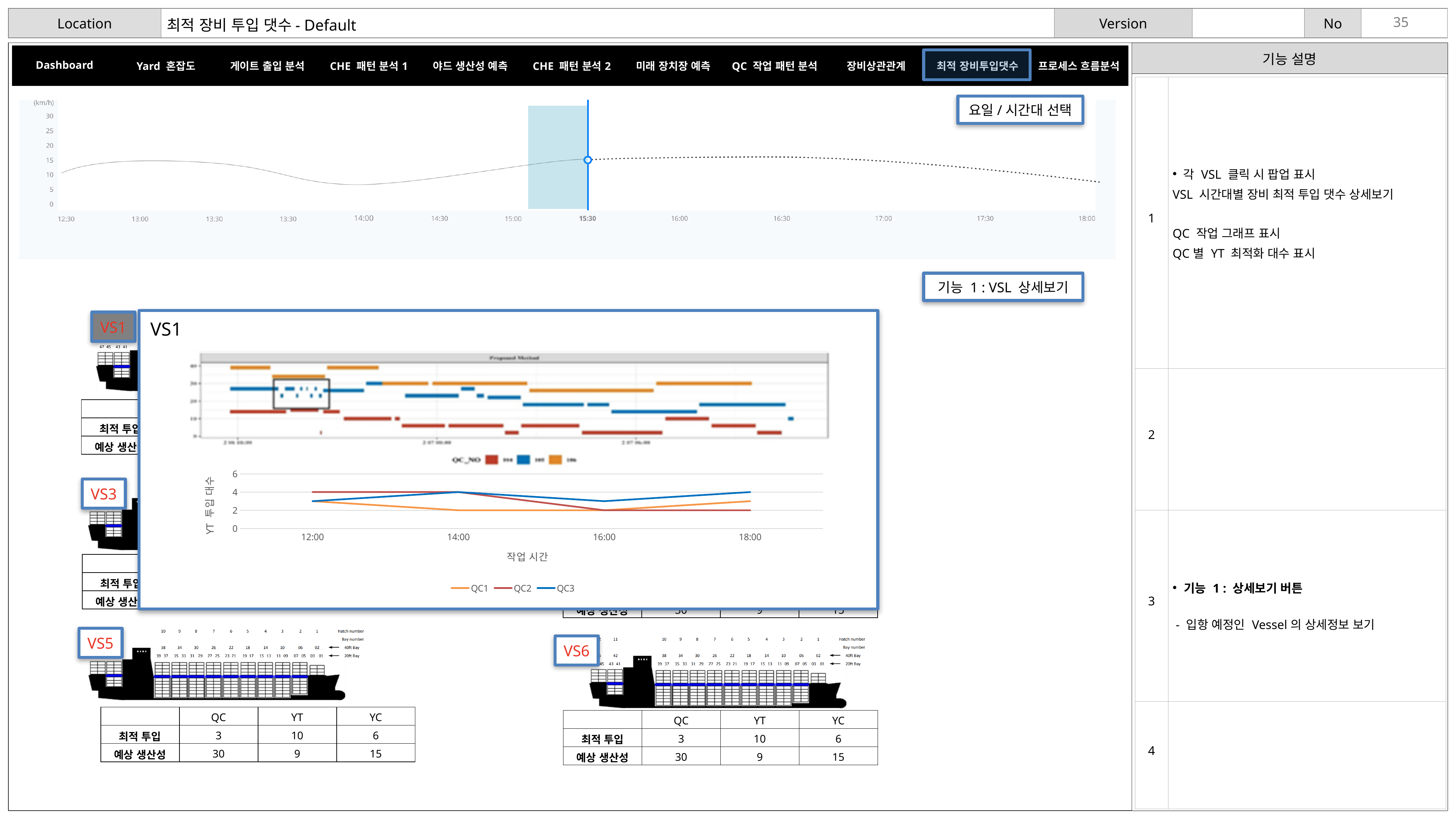
In the top (km/h) line chart, is the value at 14:00 greater or less than 10? less In the VS1 popup's YT 투입 대수 chart, which series has the highest value at 18:00? QC3 In the VS1 popup's YT 투입 대수 chart, what is the value of QC2 at 12:00? 4 In the VS1 popup's YT 투입 대수 chart, which series has the lowest value at 14:00? QC1 In the VS1 popup's YT 투입 대수 chart, what is the value of QC3 at 18:00? 4 In the VS1 popup's YT 투입 대수 line chart, how many series does the legend list? 3 What kind of chart is the YT 투입 대수 chart in the VS1 popup? line chart In the VS1 popup's YT 투입 대수 chart, what is the value of QC1 at 14:00? 2 In the VS1 popup's YT 투입 대수 chart, does QC2 rise or fall from 12:00 to 18:00? fall In the VS1 popup's YT 투입 대수 chart, how many time points are labelled on the x axis? 4 In the VS1 popup's YT 투입 대수 chart, at 16:00 which is larger, QC3 or QC2? QC3 In the VS1 popup's YT 투입 대수 chart, what is the x-axis title? 작업 시간